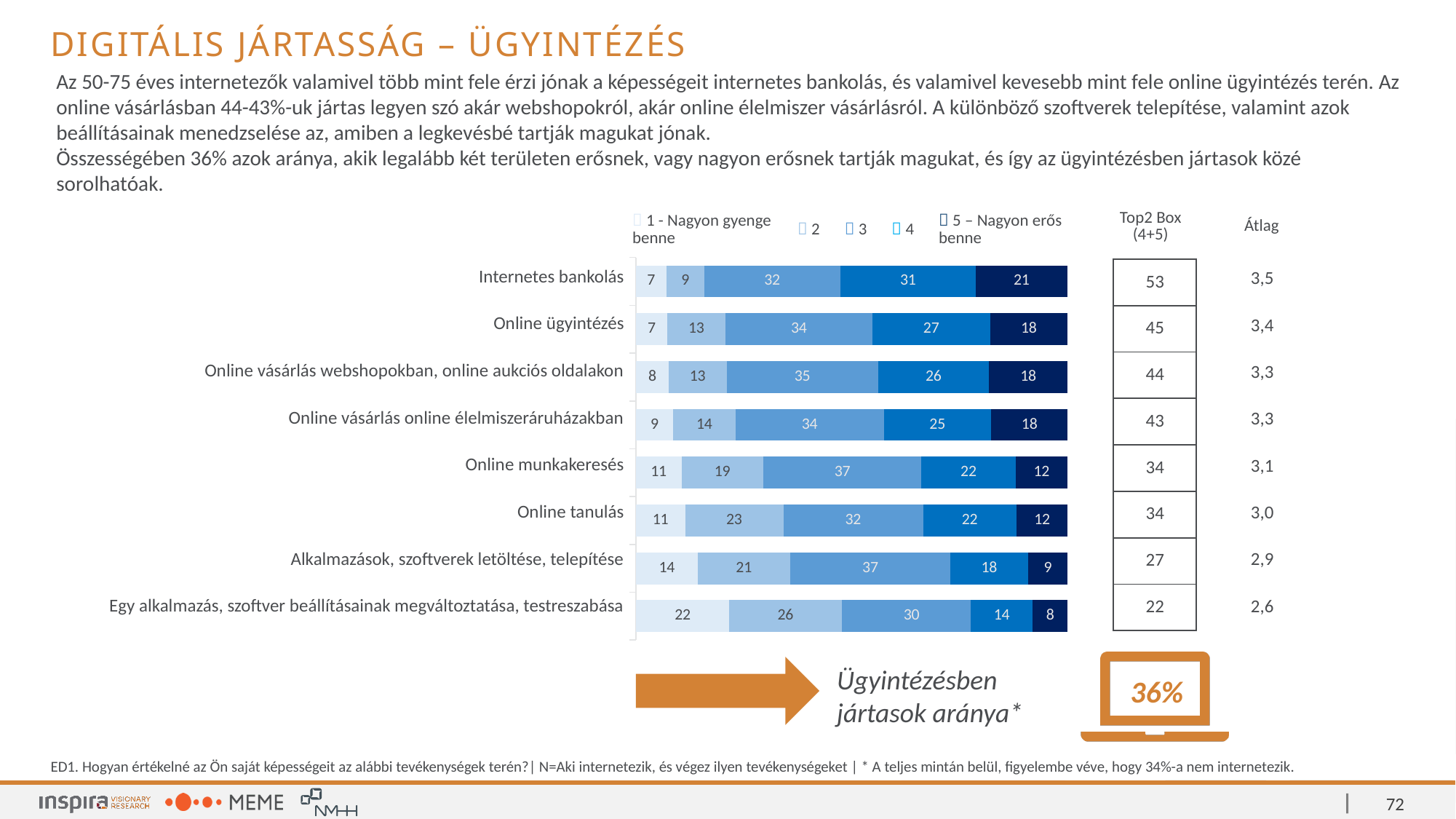
What is the Top2 Box (4+5) value shown for Online vásárlás webshopokban, online aukciós oldalakon? 44 How many categories (activities) are shown in the chart? 8 What is the value of the "4" series for Online ügyintézés? 27 How many series does the legend list? 5 What is the value of the "5 – Nagyon erős benne" series for Internetes bankolás? 21 What is the value of the "1 - Nagyon gyenge benne" series for Egy alkalmazás, szoftver beállításainak megváltoztatása, testreszabása? 22 Which category has the highest value in the "5 – Nagyon erős benne" series? Internetes bankolás What kind of chart is shown on the slide? Stacked bar chart Which category has the lowest value in the "5 – Nagyon erős benne" series? Egy alkalmazás, szoftver beállításainak megváltoztatása, testreszabása Which has the larger value in the "2" series: Online tanulás or Alkalmazások, szoftverek letöltése, telepítése? Online tanulás What is the total of the stacked bar for Internetes bankolás? 100 What is the difference between the "3" series values for Online munkakeresés and Online tanulás? 5